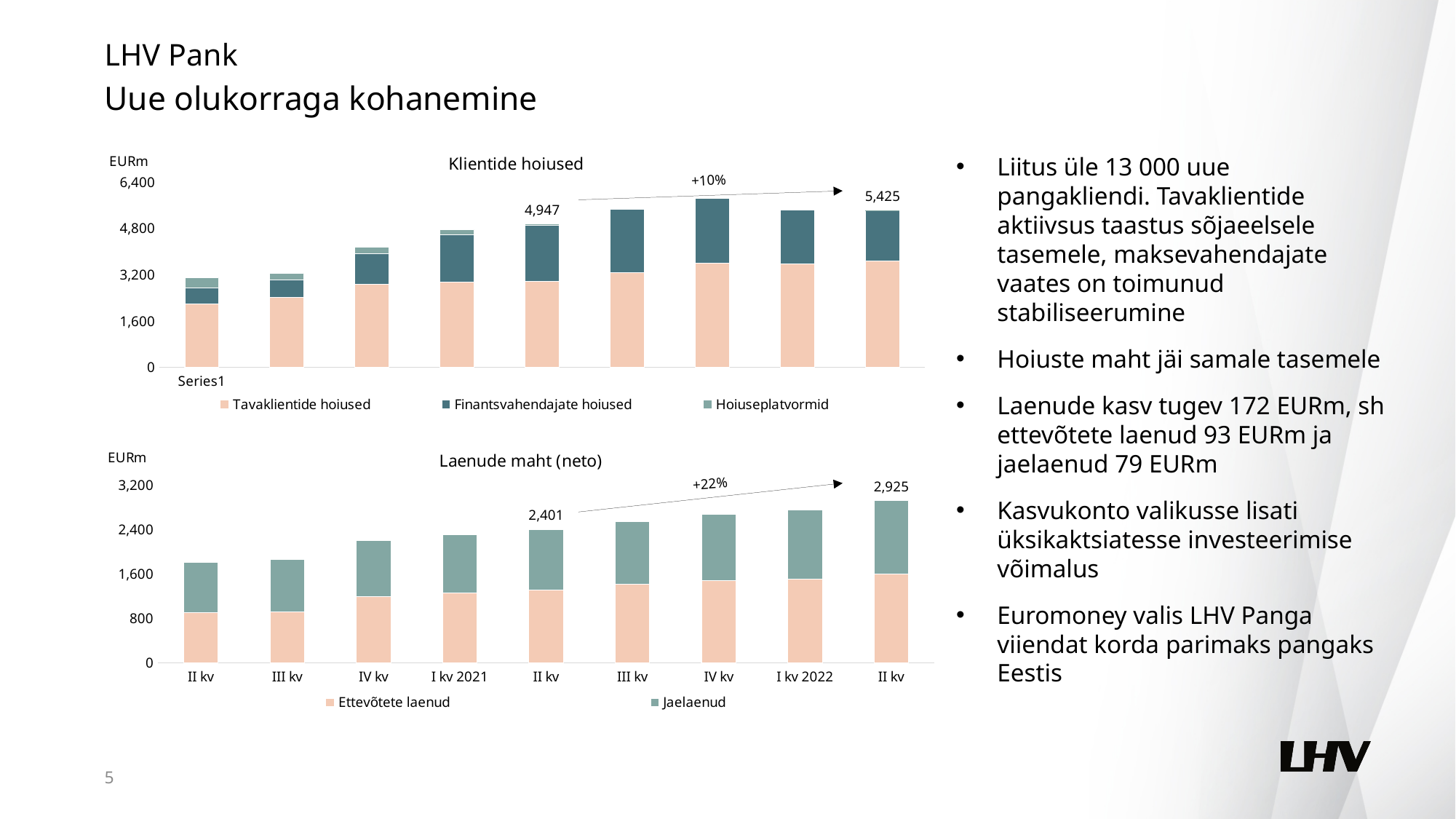
What percentage change is annotated with the arrow in the 'Laenude maht (neto)' chart? +22% How many series does the legend of the 'Laenude maht (neto)' chart list? 2 How many series does the legend of the 'Klientide hoiused' chart list? 3 In the 'Laenude maht (neto)' chart, what is the difference between the labelled totals for II kv 2022 and II kv 2021? 524 In the 'Laenude maht (neto)' chart, is the total for I kv 2022 greater or less than 2,400? greater In the 'Laenude maht (neto)' chart, what is the total value labelled for II kv 2022? 2,925 In the 'Laenude maht (neto)' chart, what is the total value labelled for II kv 2021? 2,401 In the 'Klientide hoiused' chart, what value is labelled on the last (rightmost) bar? 5,425 How many bars are plotted in the 'Laenude maht (neto)' chart? 9 In the 'Laenude maht (neto)' chart, do the bar totals rise or fall from left to right along the x axis? rise In the 'Klientide hoiused' chart, what value is labelled on the fifth bar from the left? 4,947 What kind of chart is the 'Laenude maht (neto)' chart? bar chart